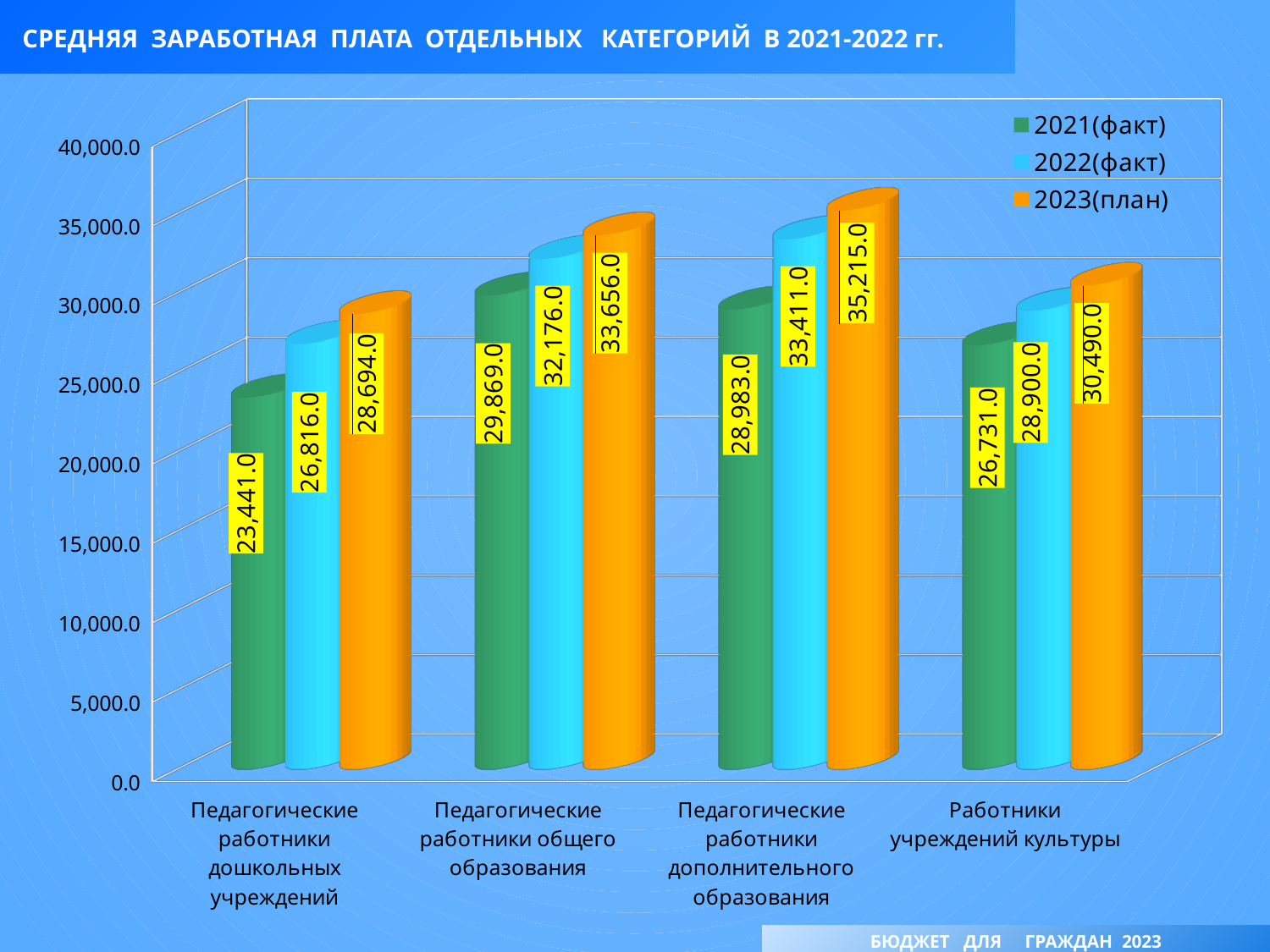
Which category has the lowest 2021(факт) value? Педагогические работники дошкольных учреждений Is the 2021(факт) value for Работники учреждений культуры greater or less than 25,000.0? greater What kind of chart is shown on the slide? bar chart How many series does the legend list? 3 Which category has the highest 2023(план) value? Педагогические работники дополнительного образования How many categories are shown on the x axis? 4 Which colour represents the 2023(план) series in the legend? orange What is the 2022(факт) value for Педагогические работники общего образования? 32,176.0 What is the 2023(план) value for Работники учреждений культуры? 30,490.0 Which is larger: the 2022(факт) value for Педагогические работники общего образования or for Педагогические работники дополнительного образования? Педагогические работники дополнительного образования What is the 2021(факт) value for Педагогические работники дошкольных учреждений? 23,441.0 What is the difference between the 2023(план) and 2021(факт) values for Педагогические работники дополнительного образования? 6,232.0